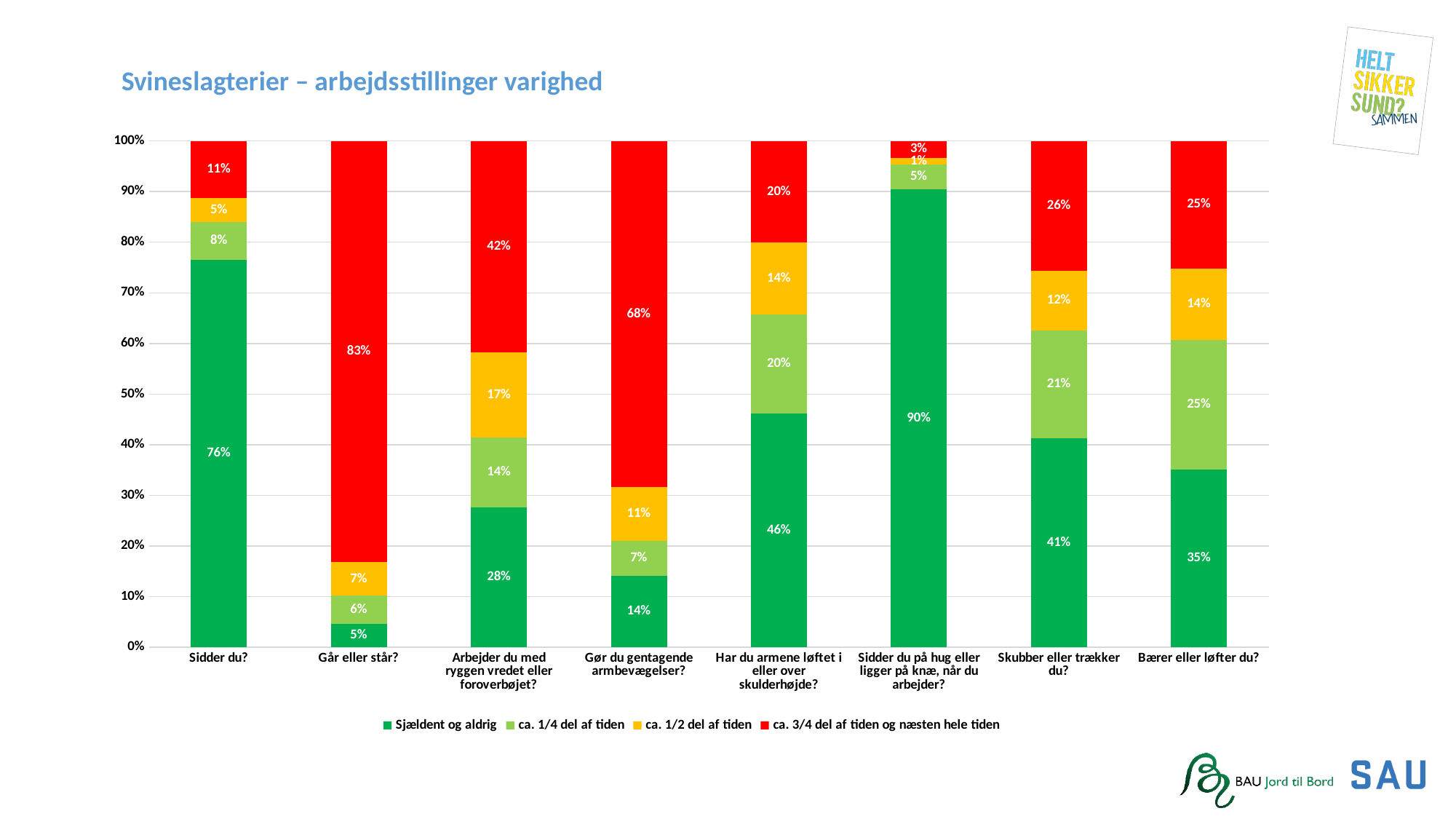
What kind of chart is shown on the slide? Stacked bar chart What is the difference between the 'ca. 3/4 del af tiden og næsten hele tiden' values for 'Går eller står?' and 'Gør du gentagende armbevægelser?'? 15% Which is larger: the 'Sjældent og aldrig' value for 'Skubber eller trækker du?' or for 'Bærer eller løfter du?'? Skubber eller trækker du? What is the value of 'ca. 3/4 del af tiden og næsten hele tiden' for 'Går eller står?'? 83% How many series does the legend list? 4 What is the value of 'ca. 1/2 del af tiden' for 'Arbejder du med ryggen vredet eller foroverbøjet?'? 17% How many categories (questions) are shown along the x axis? 8 What is the value of 'Sjældent og aldrig' for 'Sidder du?'? 76% What is the title of the chart? Svineslagterier – arbejdsstillinger varighed What is the value of 'ca. 1/4 del af tiden' for 'Bærer eller løfter du?'? 25% Which category has the highest value for 'Sjældent og aldrig'? Sidder du på hug eller ligger på knæ, når du arbejder? Which category has the lowest value for 'ca. 3/4 del af tiden og næsten hele tiden'? Sidder du på hug eller ligger på knæ, når du arbejder?